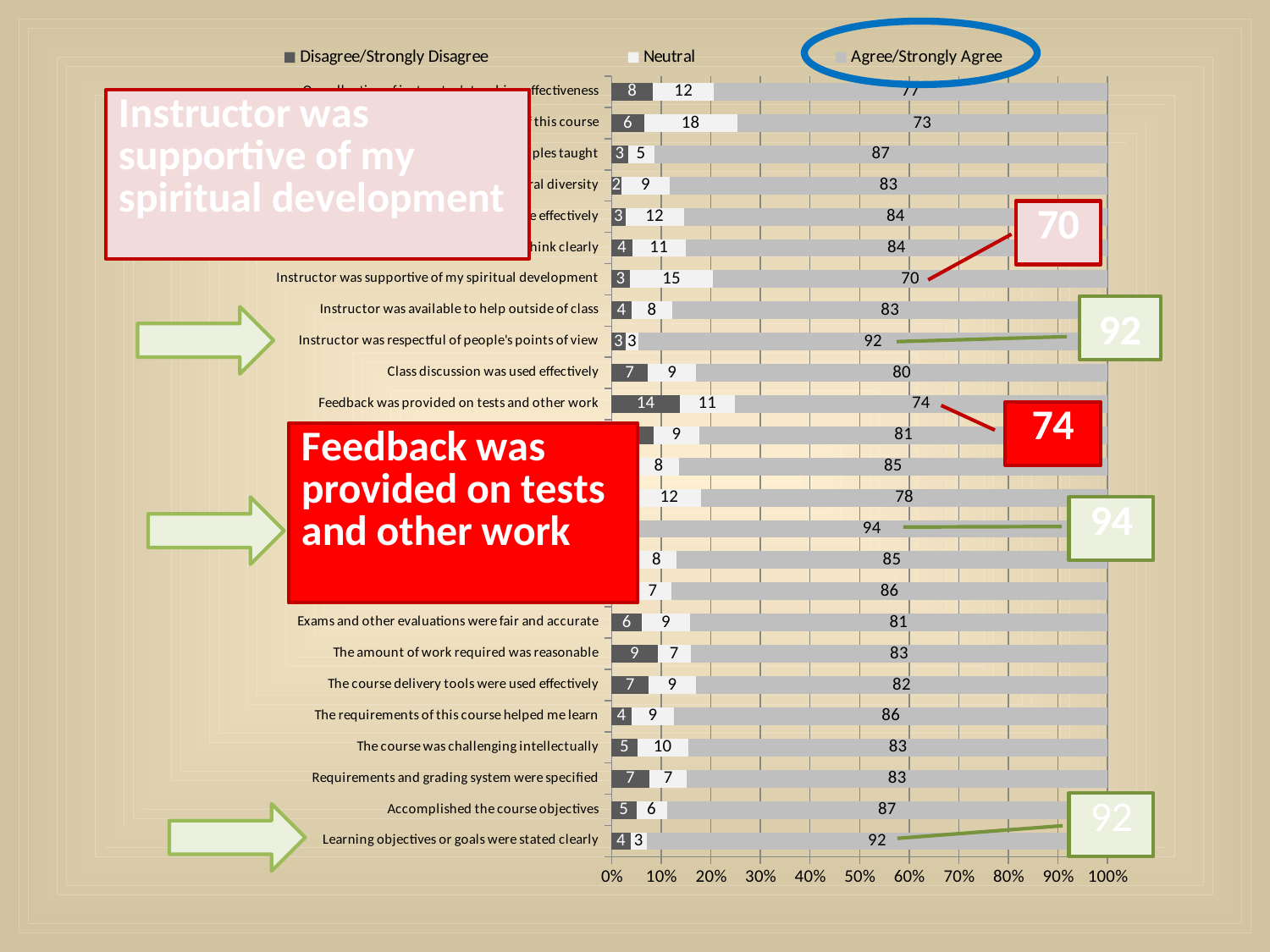
What is the Disagree/Strongly Disagree value for "Feedback was provided on tests and other work"? 14 How many categories (rows) are plotted in the chart? 25 Which has a higher Agree/Strongly Agree value: "Accomplished the course objectives" or "Exams and other evaluations were fair and accurate"? Accomplished the course objectives How many series does the legend list? 3 What kind of chart is shown on the slide? Stacked bar chart What is the total of the three segments for "Instructor was supportive of my spiritual development"? 88 Which legend entry is circled in blue? Agree/Strongly Agree What is the Agree/Strongly Agree value for "Instructor was supportive of my spiritual development"? 70 What is the Neutral value for "The course was challenging intellectually"? 10 Which category has the lowest Agree/Strongly Agree value? Instructor was supportive of my spiritual development What is the difference between the Agree/Strongly Agree values for "Instructor was respectful of people's points of view" and "Class discussion was used effectively"? 12 What is the Agree/Strongly Agree value for "Learning objectives or goals were stated clearly"? 92